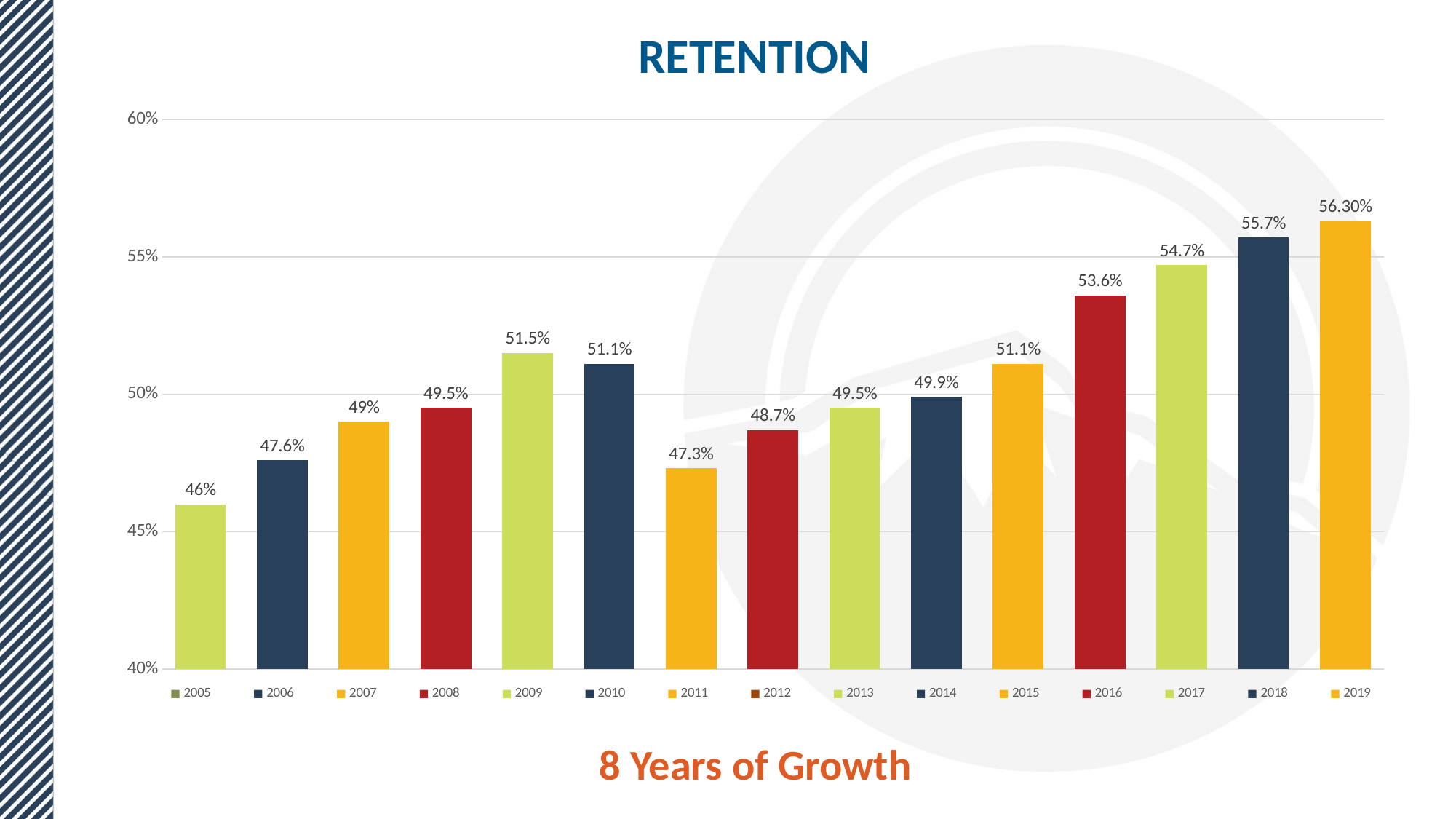
What is the title of the chart? RETENTION What is the retention value for 2019? 56.30% What kind of chart is shown on the slide? bar chart Is the retention value for 2014 greater or less than 50%? less What is the difference between the retention values for 2018 and 2017? 1% What is the retention value for 2009? 51.5% How many years are plotted in the chart? 15 What is the retention value for 2016? 53.6% Which year has the highest retention value? 2019 Which is larger, the retention value for 2011 or for 2012? 2012 Which year has the lowest retention value? 2005 How many entries does the legend list? 15